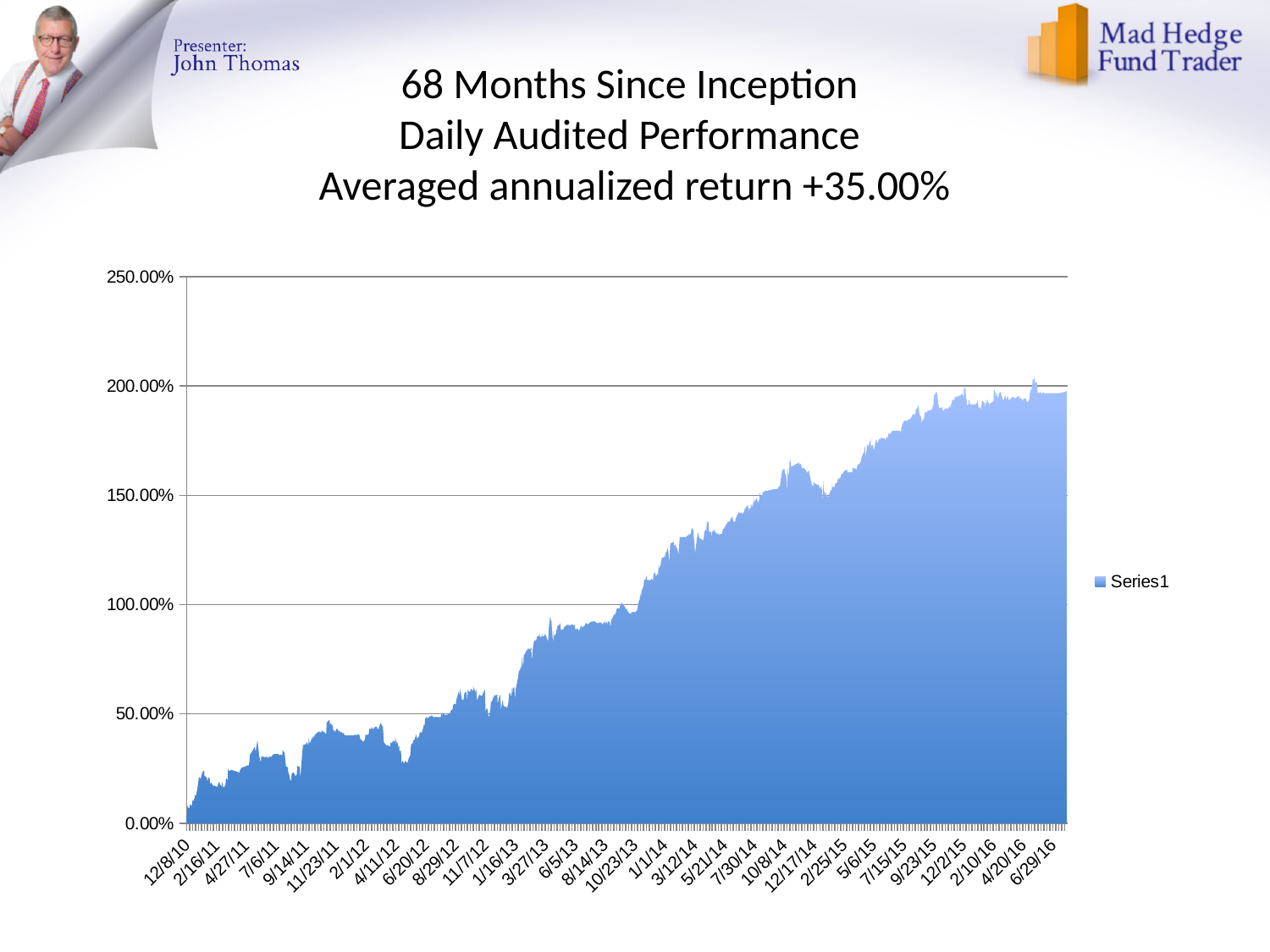
Is the value for 6/29/16 greater or less than 150.00%? greater Is the value for 12/8/10 greater or less than 50.00%? less What is the first date label on the horizontal axis? 12/8/10 Is the value for 6/20/12 greater or less than 100.00%? less Which is larger, the value for 3/27/13 or the value for 7/30/14? 7/30/14 How many series does the legend list? 1 What kind of chart is shown on the slide? Area chart What is the name of the series shown in the legend? Series1 What is the highest value shown on the vertical axis? 250.00% Do the values generally rise or fall from 12/8/10 to 6/29/16? Rise